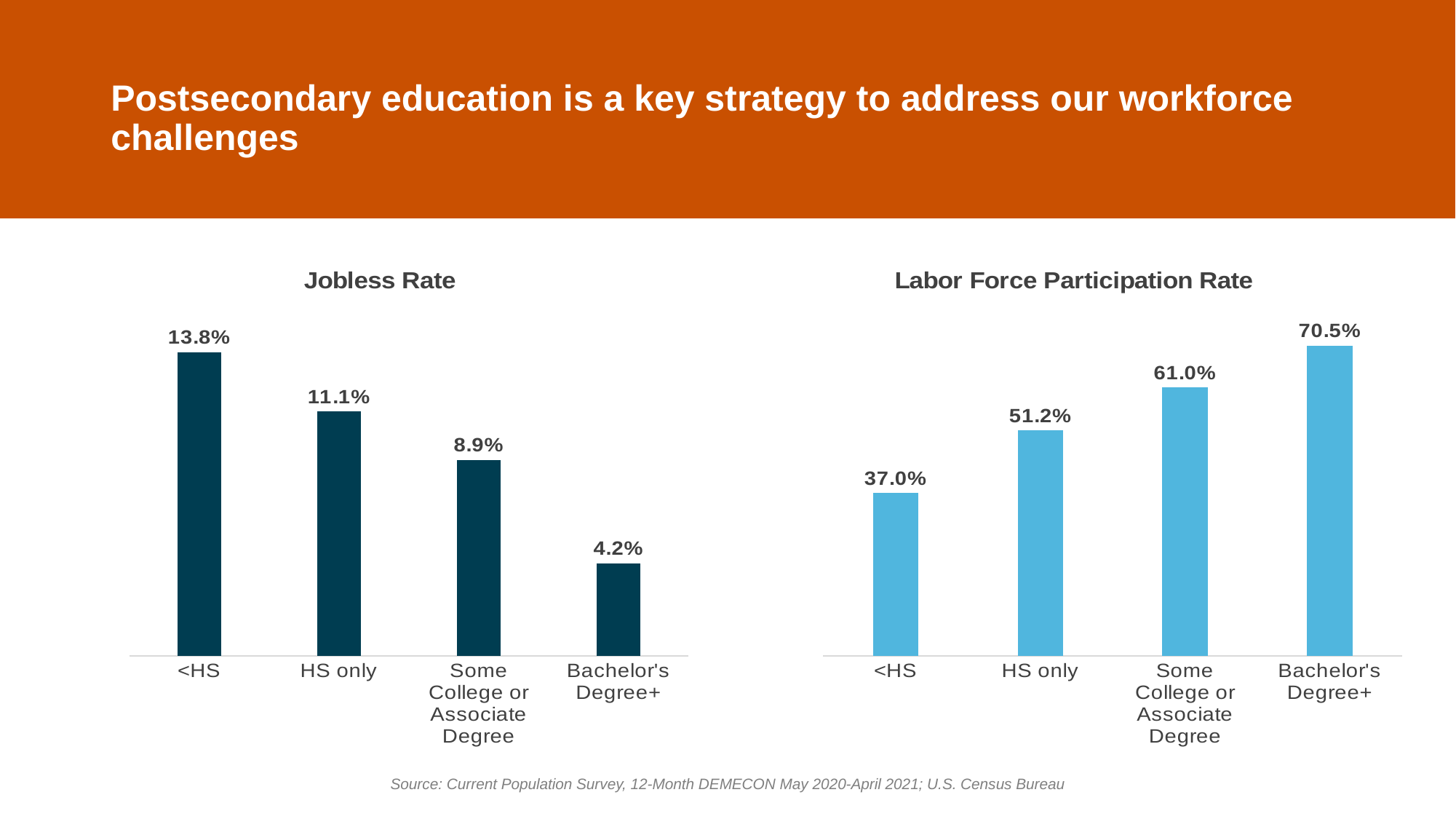
In the Jobless Rate chart, which category has the lowest value? Bachelor's Degree+ In the Labor Force Participation Rate chart, what is the difference between the values for Bachelor's Degree+ and <HS? 33.5% In the Labor Force Participation Rate chart, which category has the lowest value? <HS In the Jobless Rate chart, what is the difference between the values for <HS and HS only? 2.7% How many categories are shown in the Labor Force Participation Rate chart? 4 What kind of chart is the Jobless Rate chart? Bar chart In the Jobless Rate chart, do the values rise or fall from <HS to Bachelor's Degree+? Fall In the Labor Force Participation Rate chart, which category has the highest value? Bachelor's Degree+ In the Jobless Rate chart, what is the value for <HS? 13.8% In the Jobless Rate chart, which is larger: the value for HS only or the value for Some College or Associate Degree? HS only In the Labor Force Participation Rate chart, do the values rise or fall from <HS to Bachelor's Degree+? Rise In the Labor Force Participation Rate chart, what is the value for Some College or Associate Degree? 61.0%